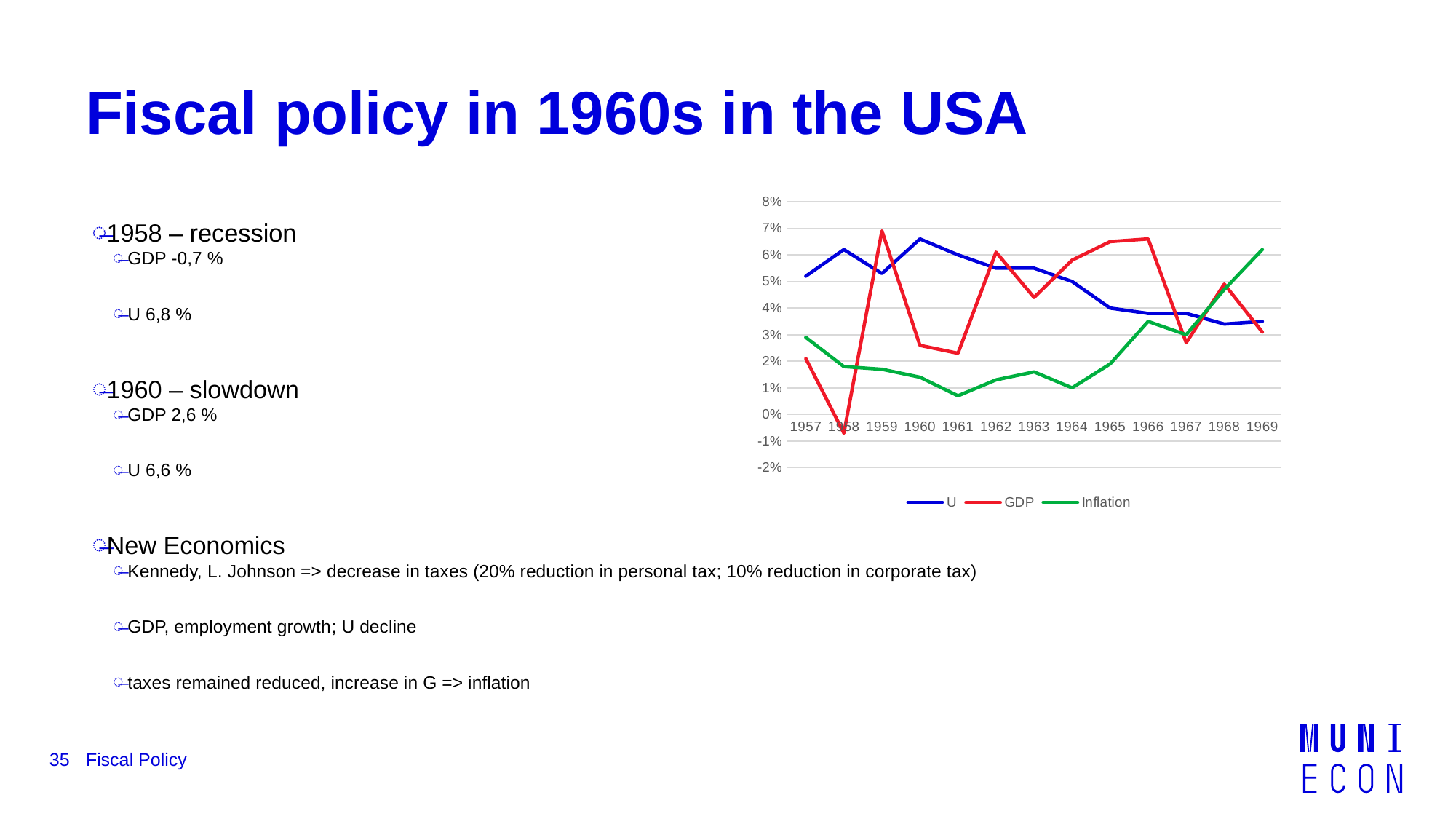
Is the U value for 1960 greater or less than 6%? greater Does the U line generally rise or fall from 1960 to 1969? fall In 1969, which is larger, Inflation or GDP? Inflation In which year is the Inflation line at its highest? 1969 Which series are listed in the chart legend? U, GDP, Inflation How many years are shown on the x axis of the chart? 13 In which year is the GDP line at its lowest? 1958 What kind of chart is shown on the slide? line chart How many series does the chart legend list? 3 In which year is the Inflation line at its lowest? 1961 Is the Inflation value for 1961 greater or less than 1%? less Is the GDP value for 1958 greater or less than 0%? less